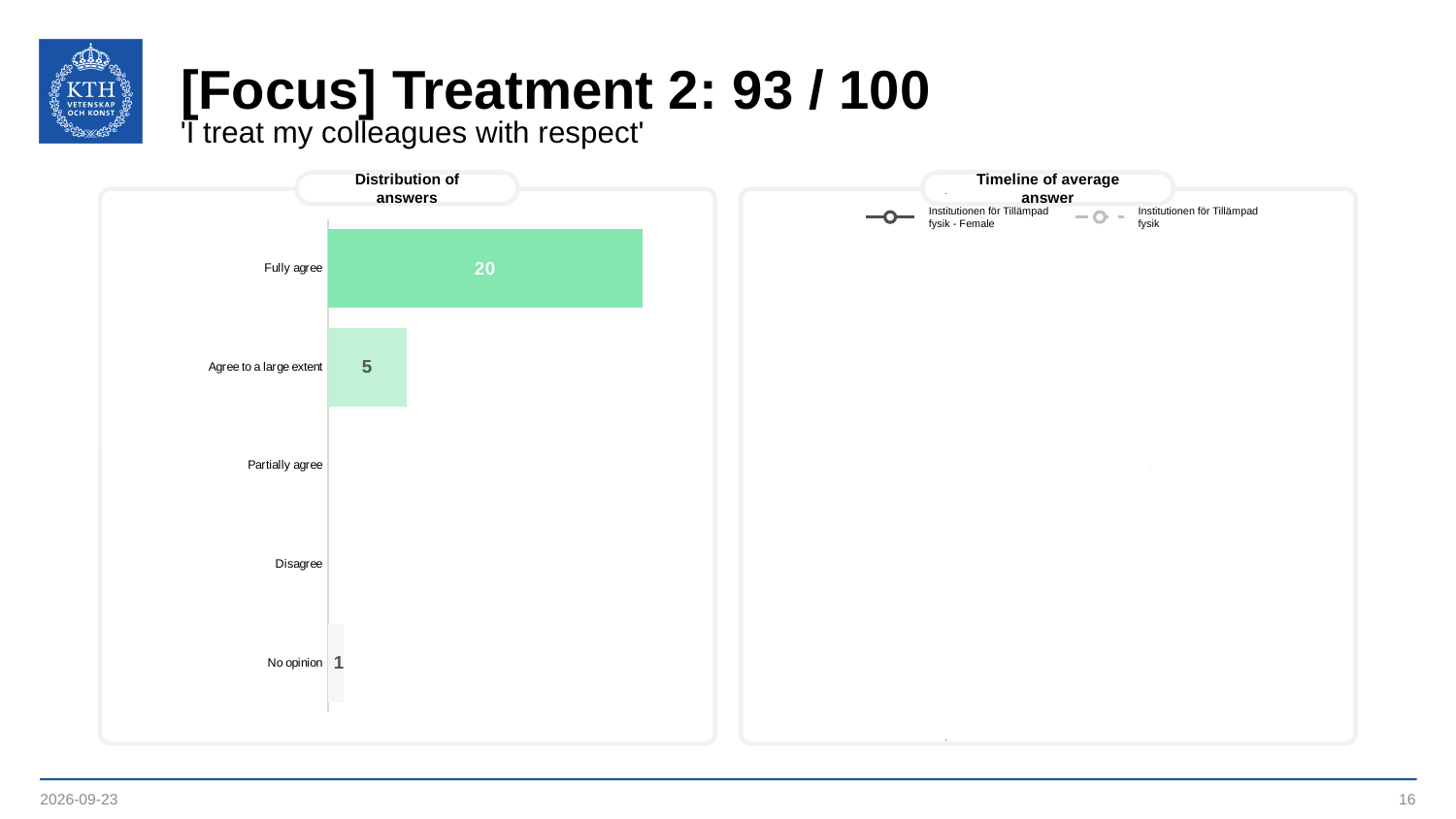
What type of chart is the 'Distribution of answers' chart? Bar chart How many series does the legend of the 'Timeline of average answer' chart list? 2 What is the title of the chart on the left side of the slide? Distribution of answers In the 'Distribution of answers' chart, what is the total of the 'Fully agree', 'Agree to a large extent' and 'No opinion' values? 26 In the 'Distribution of answers' chart, which answer category has the highest value? Fully agree In the 'Distribution of answers' chart, what is the difference between the 'Fully agree' and 'Agree to a large extent' values? 15 In the 'Timeline of average answer' chart, what is the first legend entry? Institutionen för Tillämpad fysik - Female In the 'Distribution of answers' chart, how many answer categories are listed on the axis? 5 In the 'Distribution of answers' chart, how many respondents chose 'Fully agree'? 20 In the 'Distribution of answers' chart, what is the value for 'No opinion'? 1 In the 'Distribution of answers' chart, which is larger: 'Agree to a large extent' or 'No opinion'? Agree to a large extent In the 'Distribution of answers' chart, what is the value for 'Agree to a large extent'? 5